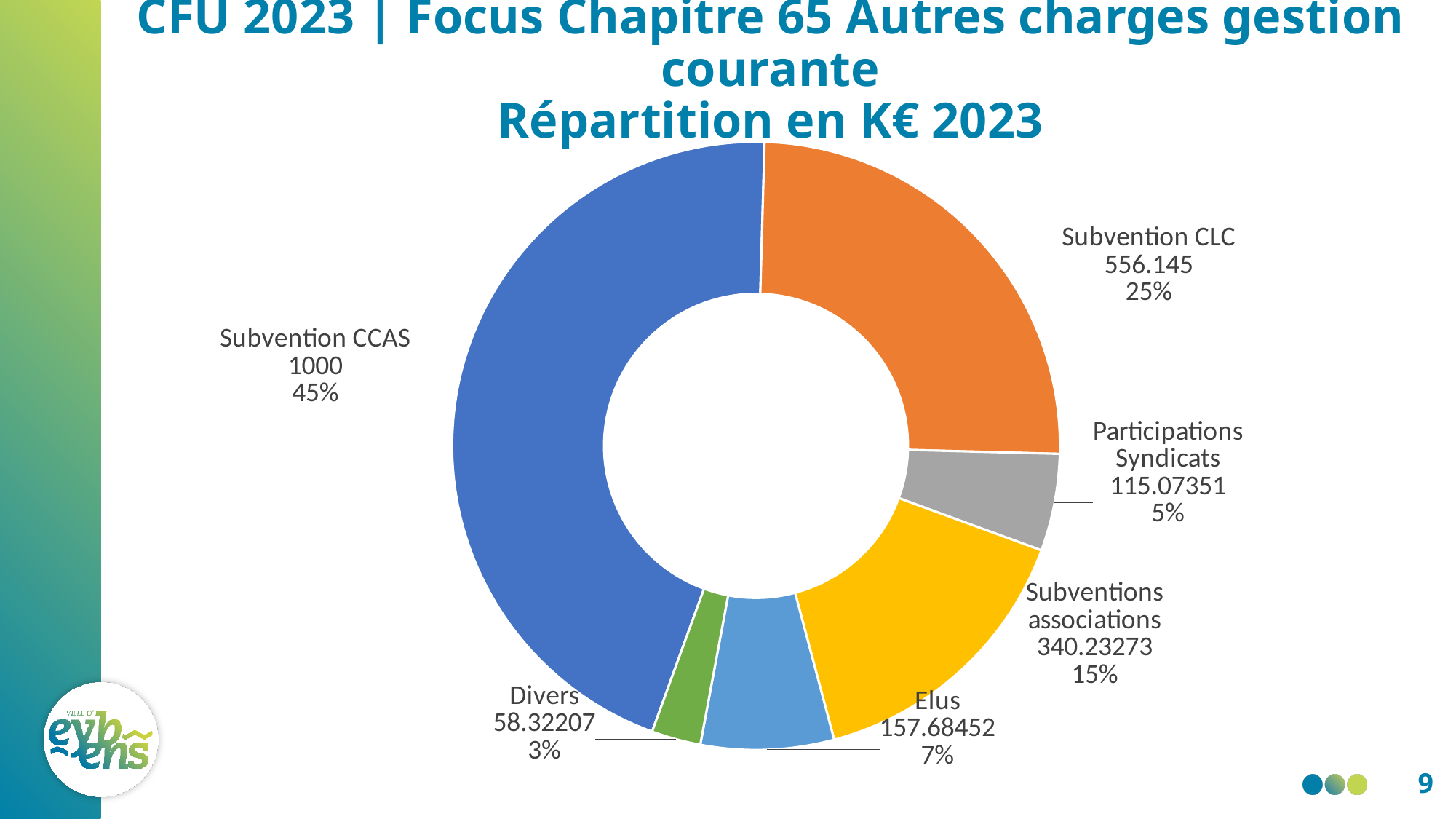
What percentage share does Subventions associations have? 15% Which is larger, the value for Subvention CLC or the value for Subventions associations? Subvention CLC How many categories are shown in the chart? 6 What is the value for Subvention CLC? 556.145 What is the value for Elus? 157.68452 What is the value for Participations Syndicats? 115.07351 What percentage share does Divers have? 3% Which category has the largest share of the chart? Subvention CCAS What colour is the Subvention CCAS slice? Blue Which category has the smallest share of the chart? Divers What kind of chart is shown on the slide? Doughnut chart What is the value for Subvention CCAS? 1000